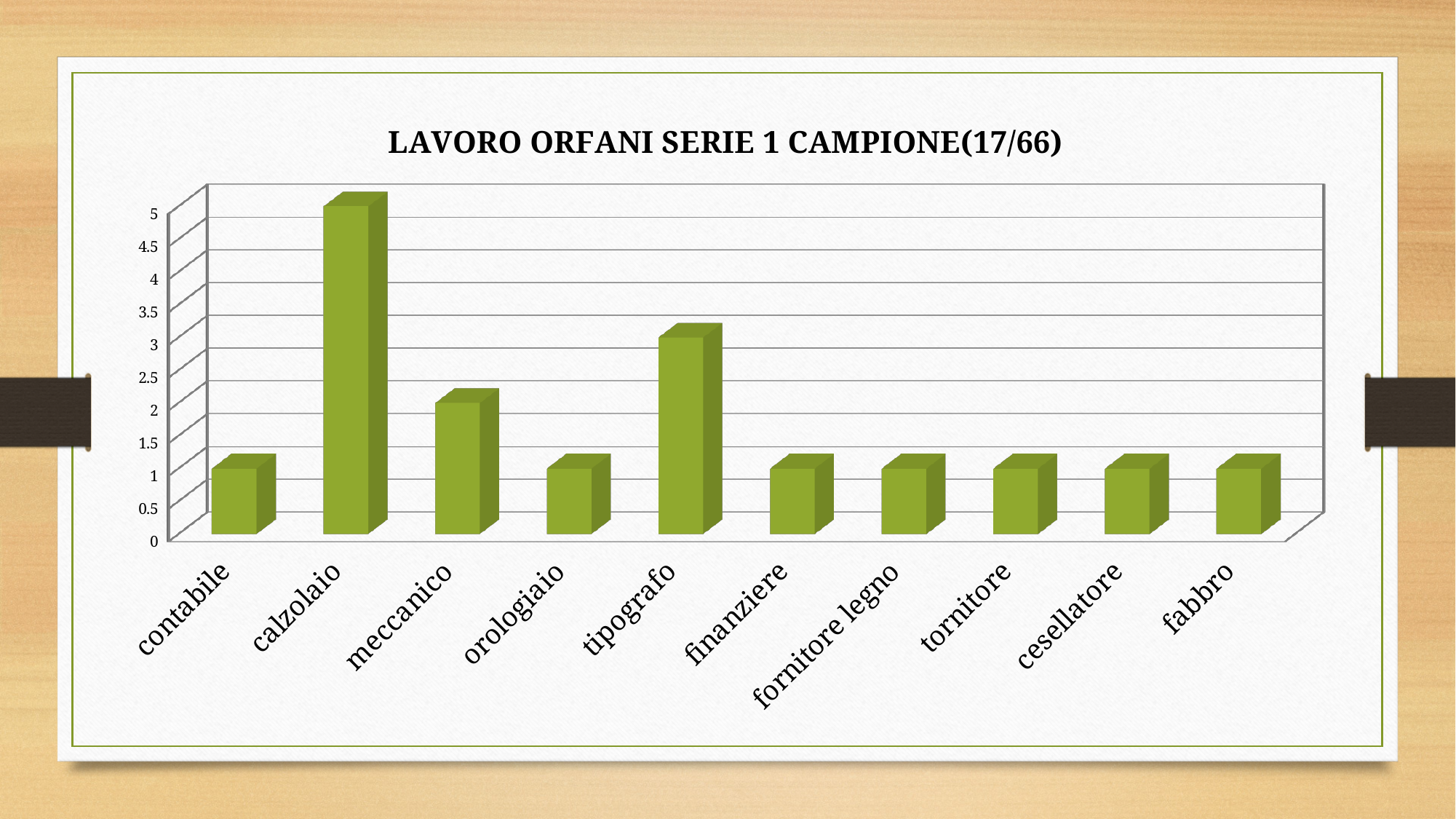
How many categories are shown on the x axis of the chart? 10 What is the title of the chart? LAVORO ORFANI SERIE 1 CAMPIONE(17/66) Is the value for calzolaio greater or less than 4? greater What is the value for meccanico? 2 What is the value for calzolaio? 5 What is the difference between the values for calzolaio and tipografo? 2 What colour are the bars in the chart? green Which is larger, the value for meccanico or the value for tipografo? tipografo What is the value for contabile? 1 What is the value for tipografo? 3 What kind of chart is shown on the slide? bar chart Which category has the highest value in the chart? calzolaio